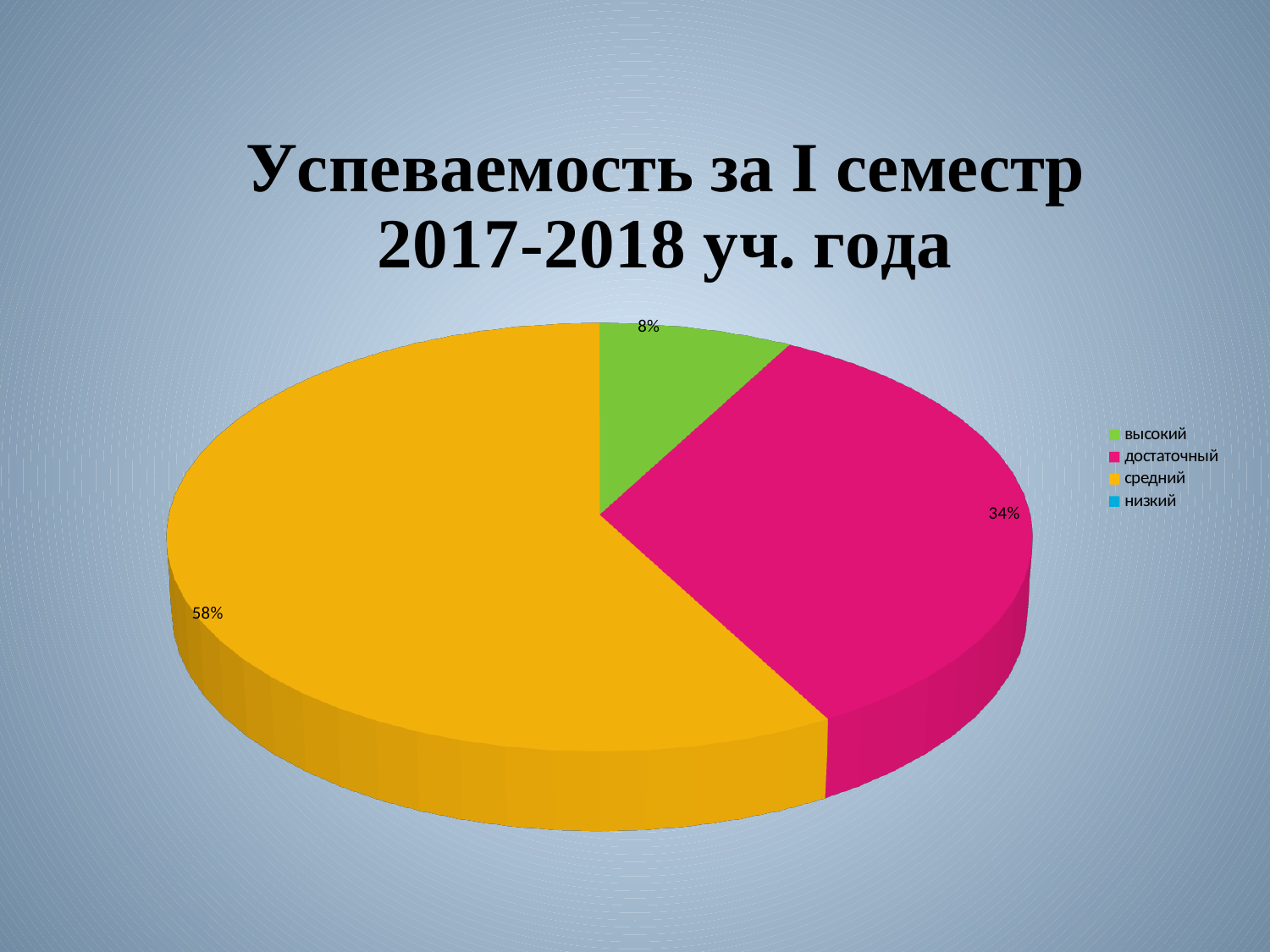
What share of the pie does the 'достаточный' slice have? 34% What is the title of the chart on the slide? Успеваемость за I семестр 2017-2018 уч. года Which of the visible slices is the smallest? высокий Which category has the largest slice of the pie? средний How many categories does the legend list? 4 What is the difference between the 'достаточный' and 'высокий' shares? 26% Which is larger, the 'достаточный' slice or the 'высокий' slice? достаточный What share of the pie does the 'средний' slice have? 58% What colour is the 'средний' slice? yellow What is the difference between the 'средний' and 'достаточный' shares? 24% What share of the pie does the 'высокий' slice have? 8% What kind of chart is shown on the slide? pie chart